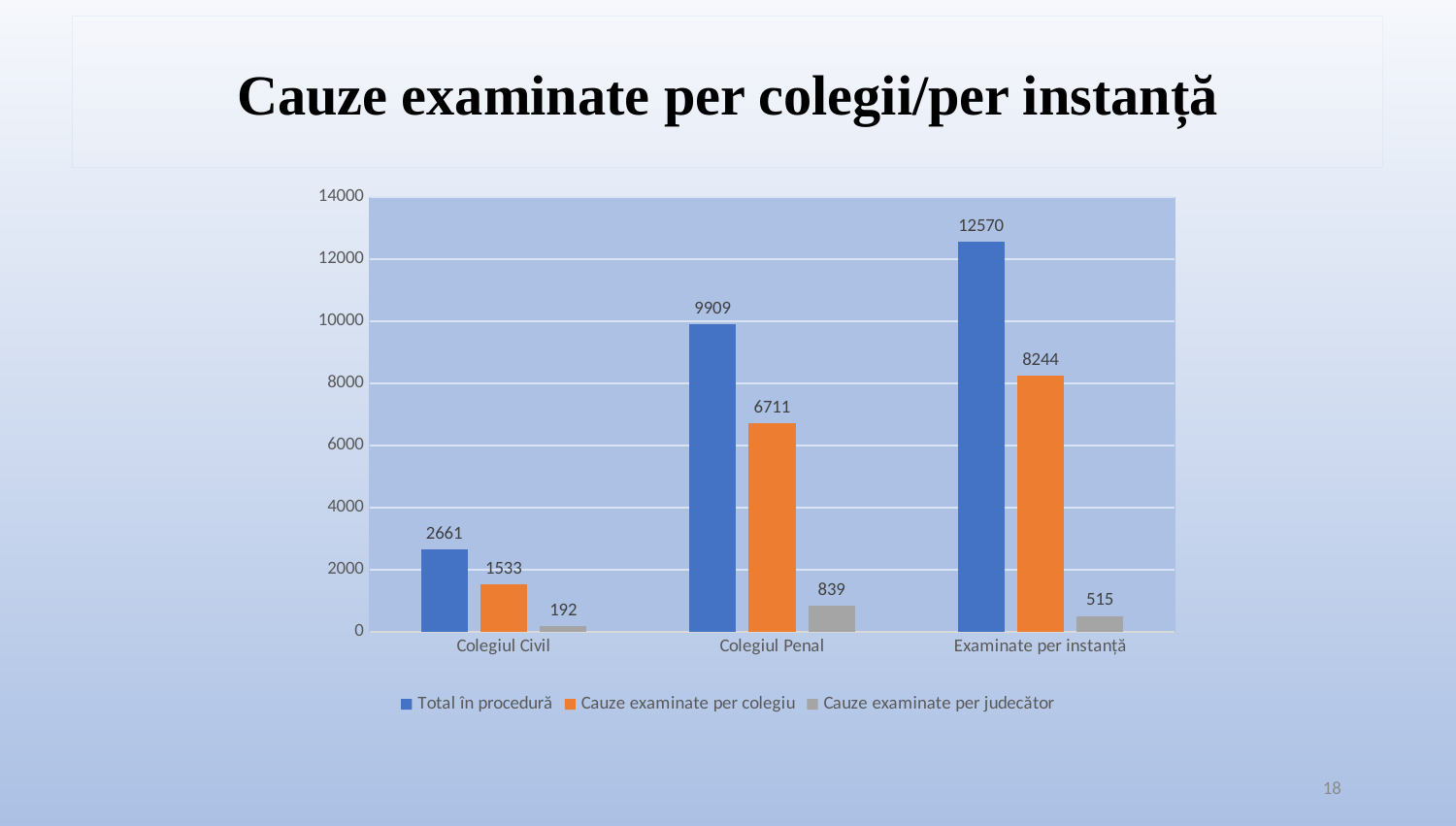
How many series does the legend list? 3 What is the title of the chart? Cauze examinate per colegii/per instanță How many categories are shown on the x axis? 3 Which is larger: 'Cauze examinate per judecător' for Colegiul Penal or for Examinate per instanță? Colegiul Penal What is the value of 'Total în procedură' for Colegiul Penal? 9909 What is the value of 'Cauze examinate per judecător' for Examinate per instanță? 515 What is the value of 'Cauze examinate per colegiu' for Colegiul Civil? 1533 Which category has the highest value for 'Total în procedură'? Examinate per instanță What is the difference between 'Total în procedură' and 'Cauze examinate per colegiu' for Colegiul Penal? 3198 What kind of chart is shown on the slide? bar chart Is the value of 'Cauze examinate per colegiu' for Examinate per instanță greater or less than 8000? greater Which category has the lowest value for 'Cauze examinate per judecător'? Colegiul Civil